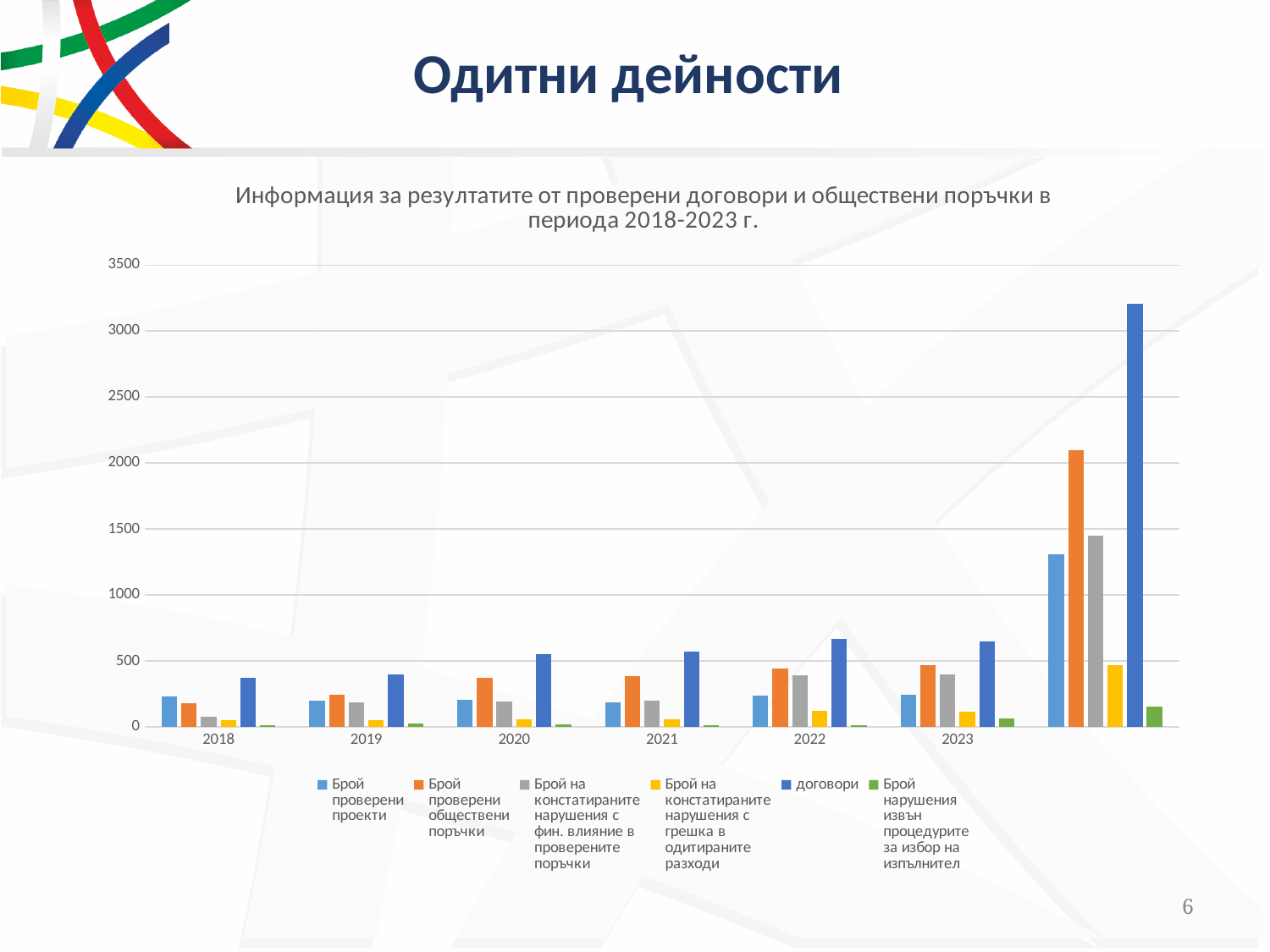
What kind of chart is shown on the slide? bar chart How many series does the chart legend list? 6 What is the title of the chart? Информация за резултатите от проверени договори и обществени поръчки в периода 2018-2023 г. In 2021, which is larger: "Брой проверени проекти" or "Брой проверени обществени поръчки"? Брой проверени обществени поръчки Which series has the lowest value in 2018? Брой нарушения извън процедурите за избор на изпълнител Is the value for "договори" in the unlabeled rightmost group greater or less than 3000? greater Which colour represents the series "договори" in the chart? dark blue Which series has the highest value in 2023? договори Is the value for "договори" in 2023 greater or less than 500? greater How many years are labeled on the x axis of the chart? 6 Is the value for "договори" in 2018 greater or less than 500? less